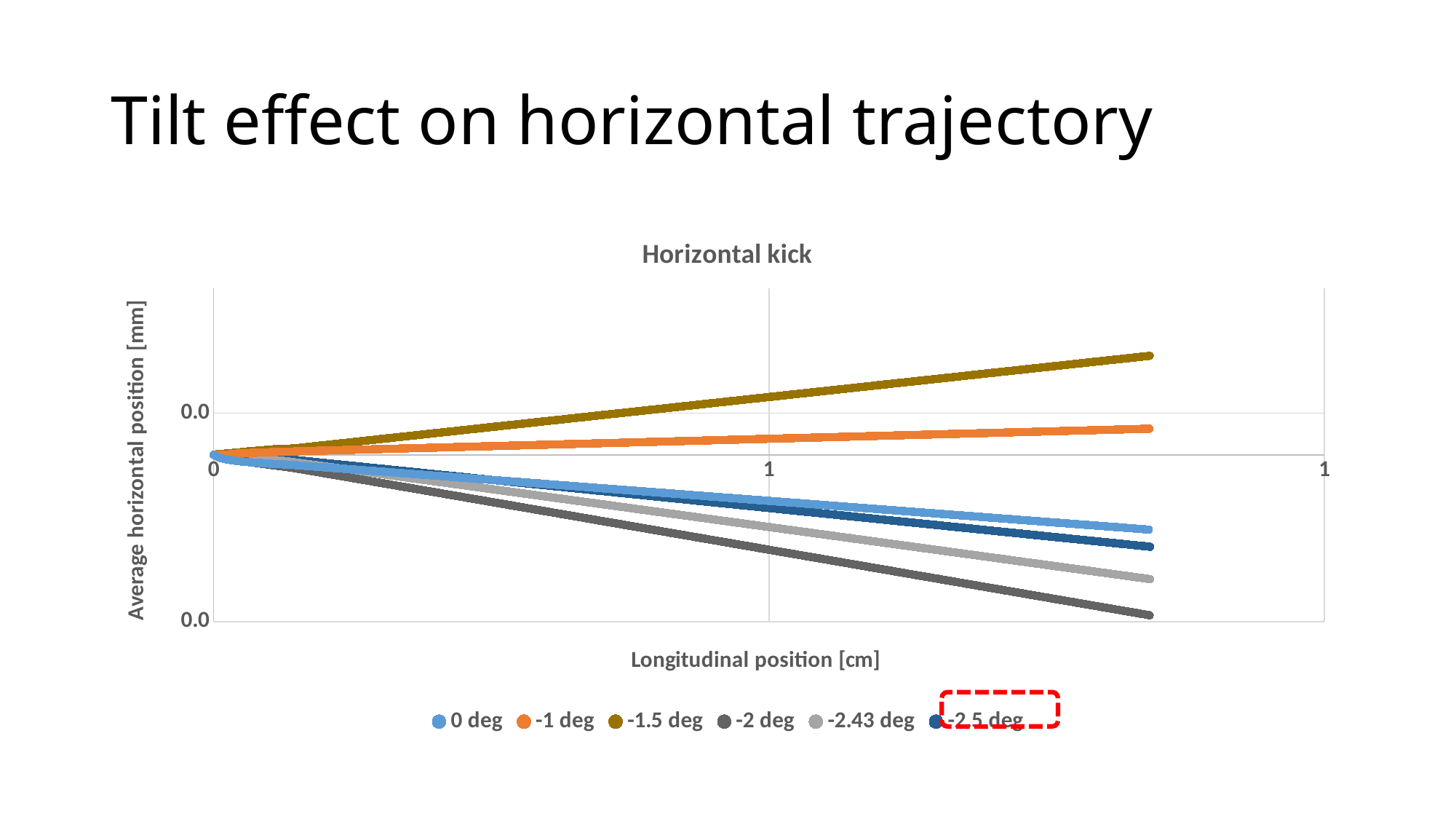
Which legend entry is enclosed in a red dashed box? -2.5 deg At the right end of the chart, which series is higher: '-1.5 deg' or '-1 deg'? -1.5 deg What kind of chart is shown on the slide? Line chart Does the '-1 deg' series rise or fall along the x axis? Rise How many series does the legend of the 'Horizontal kick' chart list? 6 What is the title of the chart? Horizontal kick Which series reaches the highest average horizontal position at the right end of the chart? -1.5 deg At the right end of the chart, which series is lower: '-2 deg' or '-2.43 deg'? -2 deg Does the '-2 deg' series rise or fall as longitudinal position increases? Fall Does the '-2.43 deg' series rise or fall along the x axis? Fall Which series reaches the lowest average horizontal position at the right end of the chart? -2 deg